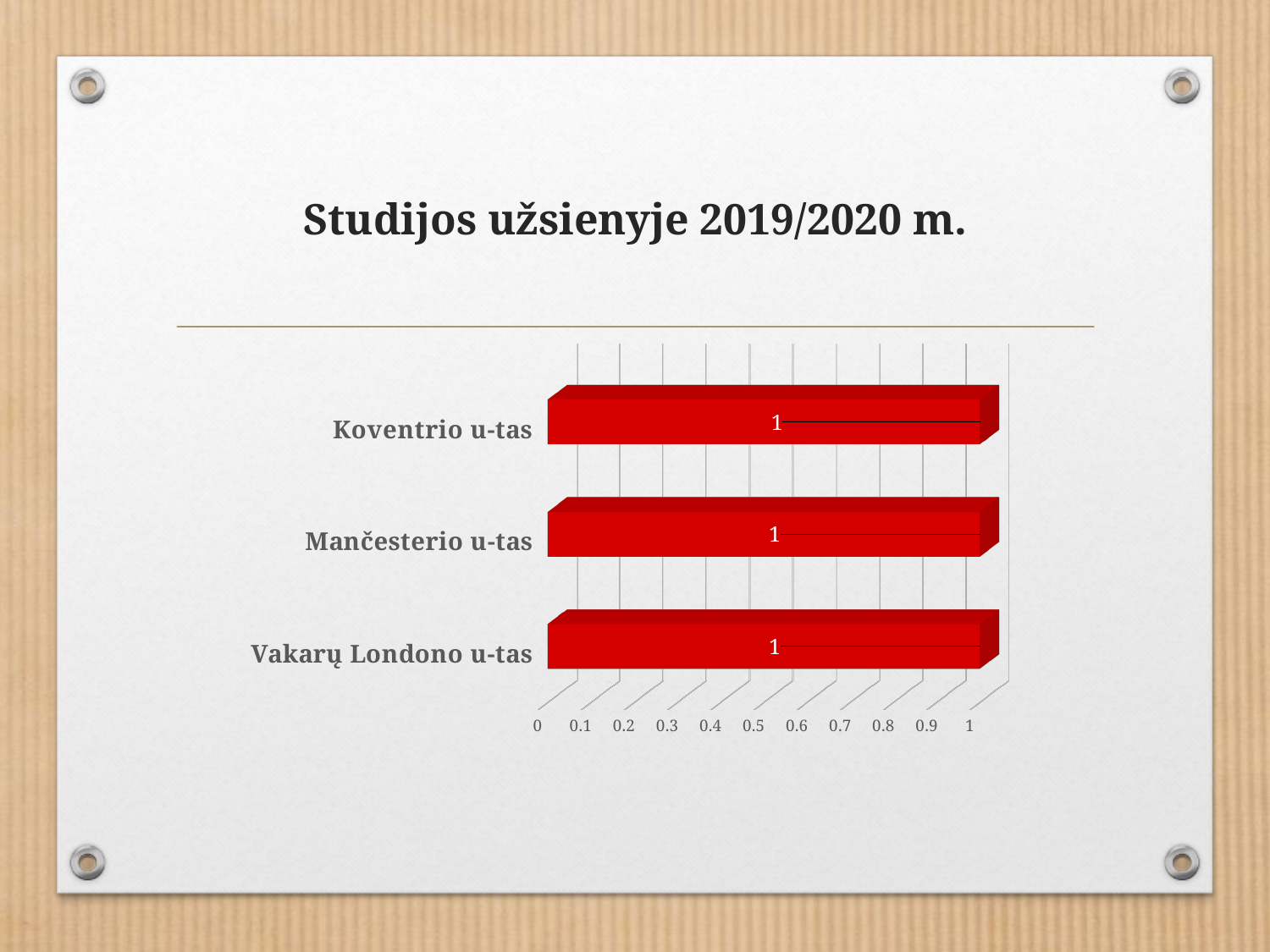
What is the value for Koventrio u-tas? 1 Is the value for Koventrio u-tas greater or less than 0.8? greater What colour are the bars in the chart? red Which category is listed at the top of the chart? Koventrio u-tas Is the value for Vakarų Londono u-tas greater or less than 0.5? greater What kind of chart is shown on the slide? bar chart What is the difference between the values for Koventrio u-tas and Mančesterio u-tas? 0 What is the value for Vakarų Londono u-tas? 1 How many categories are shown in the chart? 3 What is the value for Mančesterio u-tas? 1 What is the title of the slide containing the chart? Studijos užsienyje 2019/2020 m.